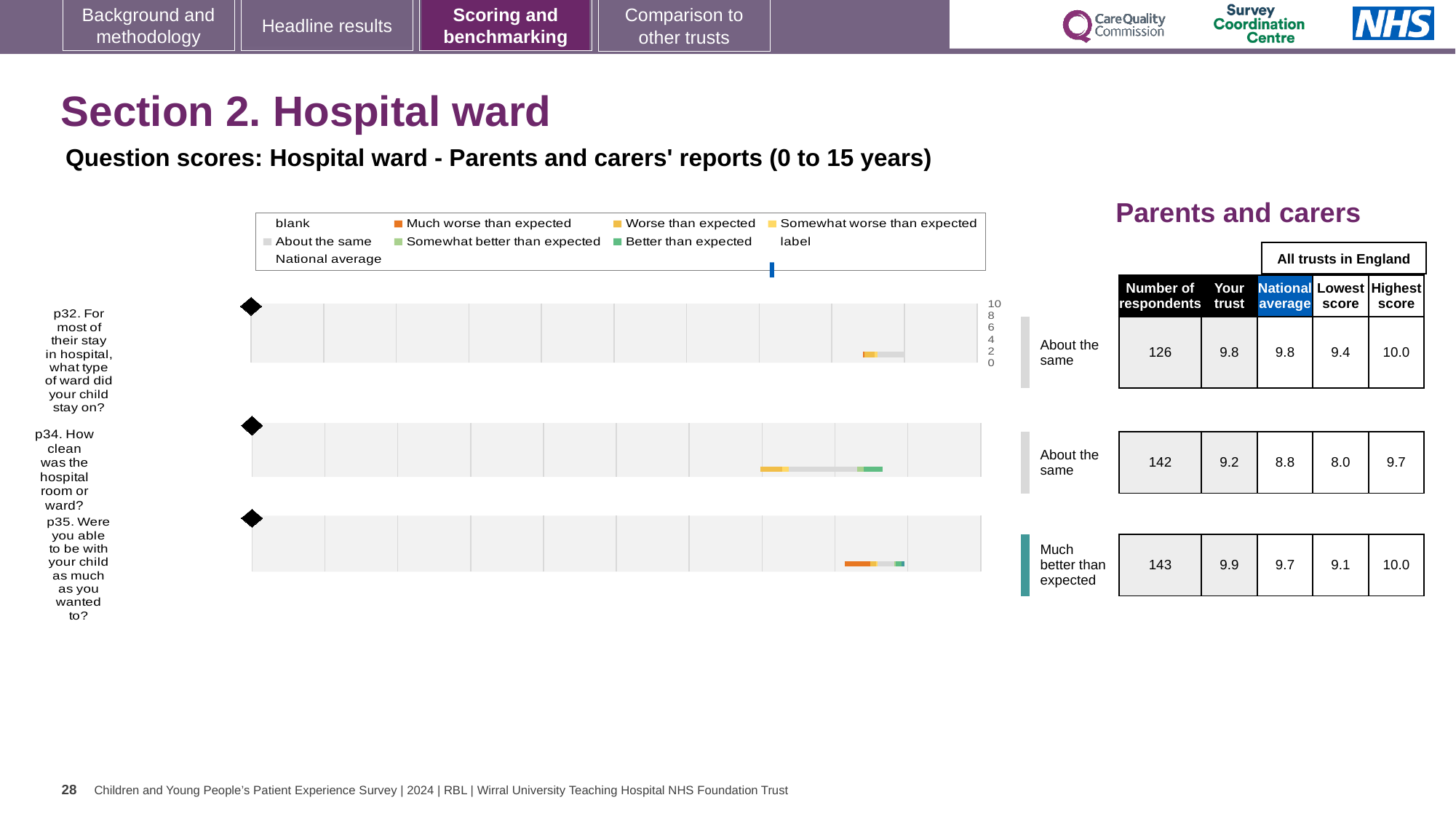
In the table beside the chart, what is the difference between the highest score and the lowest score for the second row (p34)? 1.7 What is the heading above the chart describing the question scores? Question scores: Hospital ward - Parents and carers' reports (0 to 15 years) In the table beside the chart, what is the number of respondents for the first row (p32)? 126 Which row in the table beside the chart has the highest 'Your trust' score? p35 (9.9) How many entries does the chart legend list? 9 In the table beside the chart, what is the 'Your trust' score for the second row (p34, how clean was the hospital room or ward)? 9.2 Which row in the table beside the chart has the lowest 'Lowest score' value? p34 (8.0) What kind of chart is shown on the slide? bar chart In the table beside the chart, which has more respondents: the second row (p34) or the third row (p35)? p35 (143) How many questions (categories) are plotted in the chart? 3 In the table beside the chart, what is the national average for the third row (p35)? 9.7 What colour represents 'Much worse than expected' in the chart legend? orange